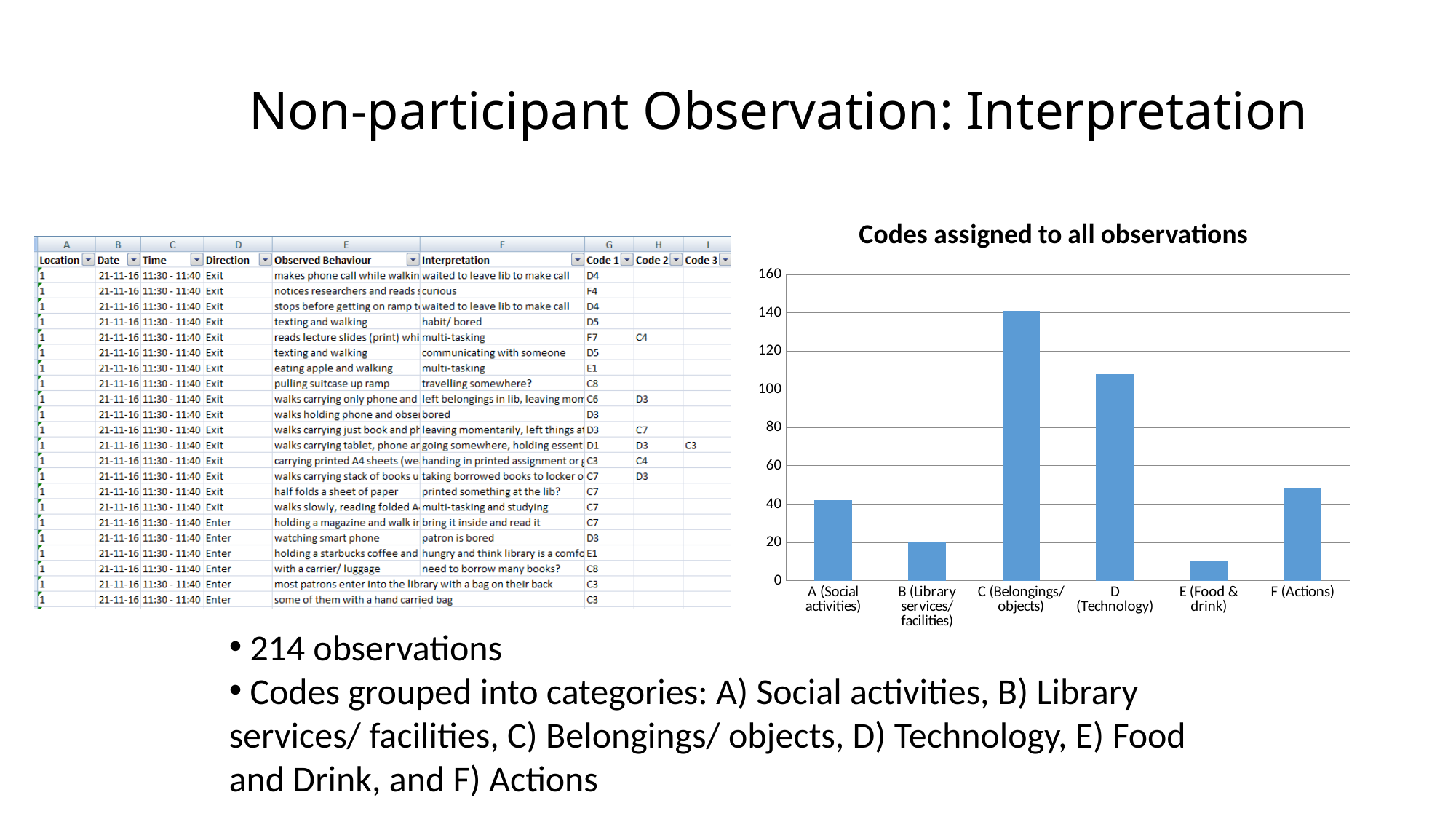
Is the value for F (Actions) greater or less than 60? less Which category has the highest bar in the chart? C (Belongings/ objects) What type of chart is shown under the title "Codes assigned to all observations"? bar chart Which is larger, the value for A (Social activities) or the value for B (Library services/ facilities)? A (Social activities) Is the value for E (Food & drink) greater or less than 20? less How many categories are shown on the x axis of the chart? 6 Which category has the lowest bar in the chart? E (Food & drink) Which is larger, the value for D (Technology) or the value for F (Actions)? D (Technology) What is the title of the chart on the slide? Codes assigned to all observations Is the value for D (Technology) greater or less than 100? greater